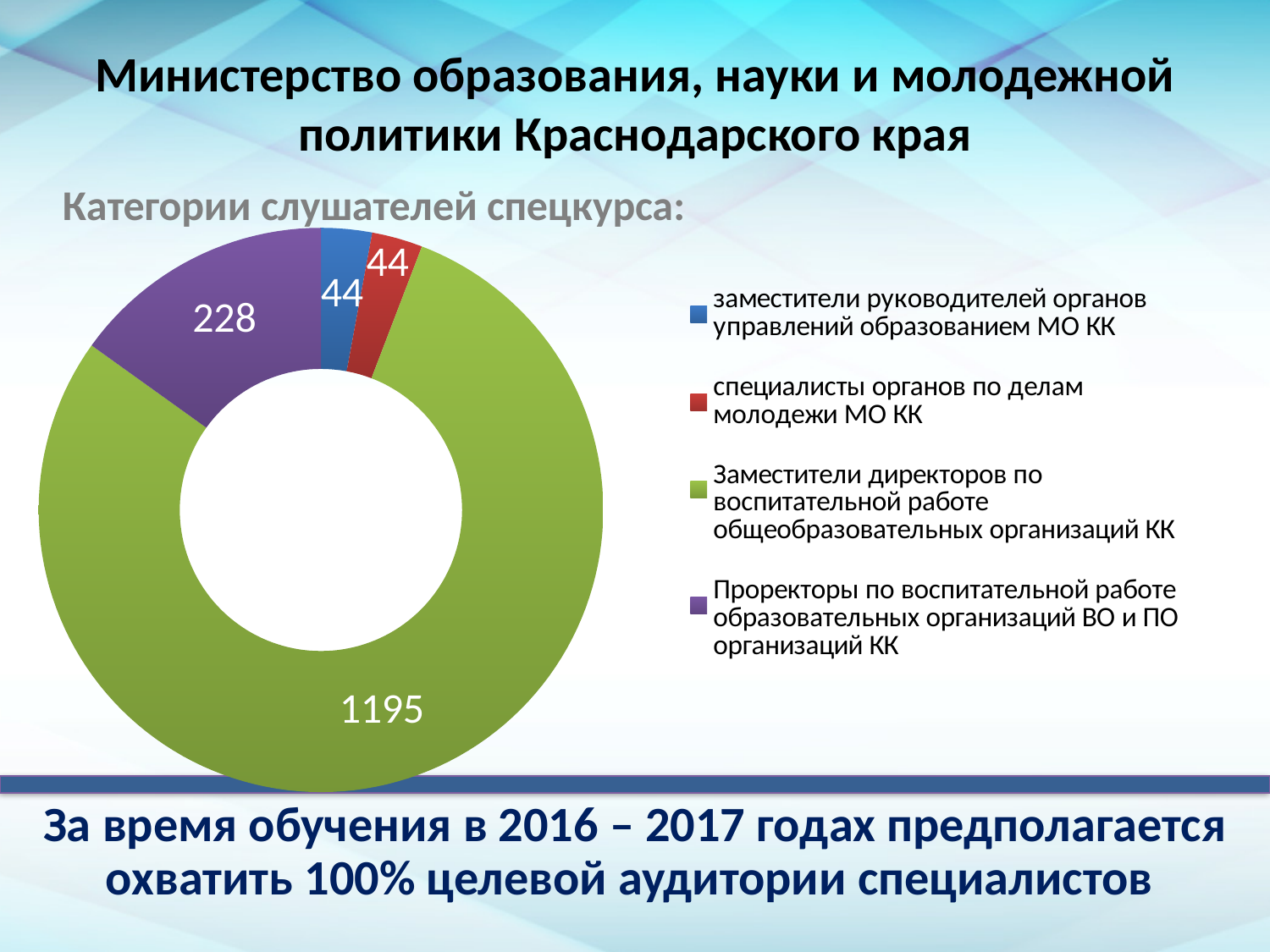
What is the difference between the value for Проректоры по воспитательной работе образовательных организаций ВО и ПО организаций КК and the value for специалисты органов по делам молодежи МО КК? 184 What kind of chart is shown on the slide? Doughnut (pie) chart What is the title of the chart? Категории слушателей спецкурса: What is the value for Заместители директоров по воспитательной работе общеобразовательных организаций КК? 1195 How many categories are shown in the chart? 4 What is the difference between the value for Заместители директоров по воспитательной работе общеобразовательных организаций КК and the value for Проректоры по воспитательной работе образовательных организаций ВО и ПО организаций КК? 967 Which category has the highest value? Заместители директоров по воспитательной работе общеобразовательных организаций КК What is the total of all the values shown in the chart? 1511 What is the value for Проректоры по воспитательной работе образовательных организаций ВО и ПО организаций КК? 228 What is the value for специалисты органов по делам молодежи МО КК? 44 Which is larger: the value for Проректоры по воспитательной работе образовательных организаций ВО и ПО организаций КК or the value for специалисты органов по делам молодежи МО КК? Проректоры по воспитательной работе образовательных организаций ВО и ПО организаций КК What is the value for заместители руководителей органов управлений образованием МО КК? 44